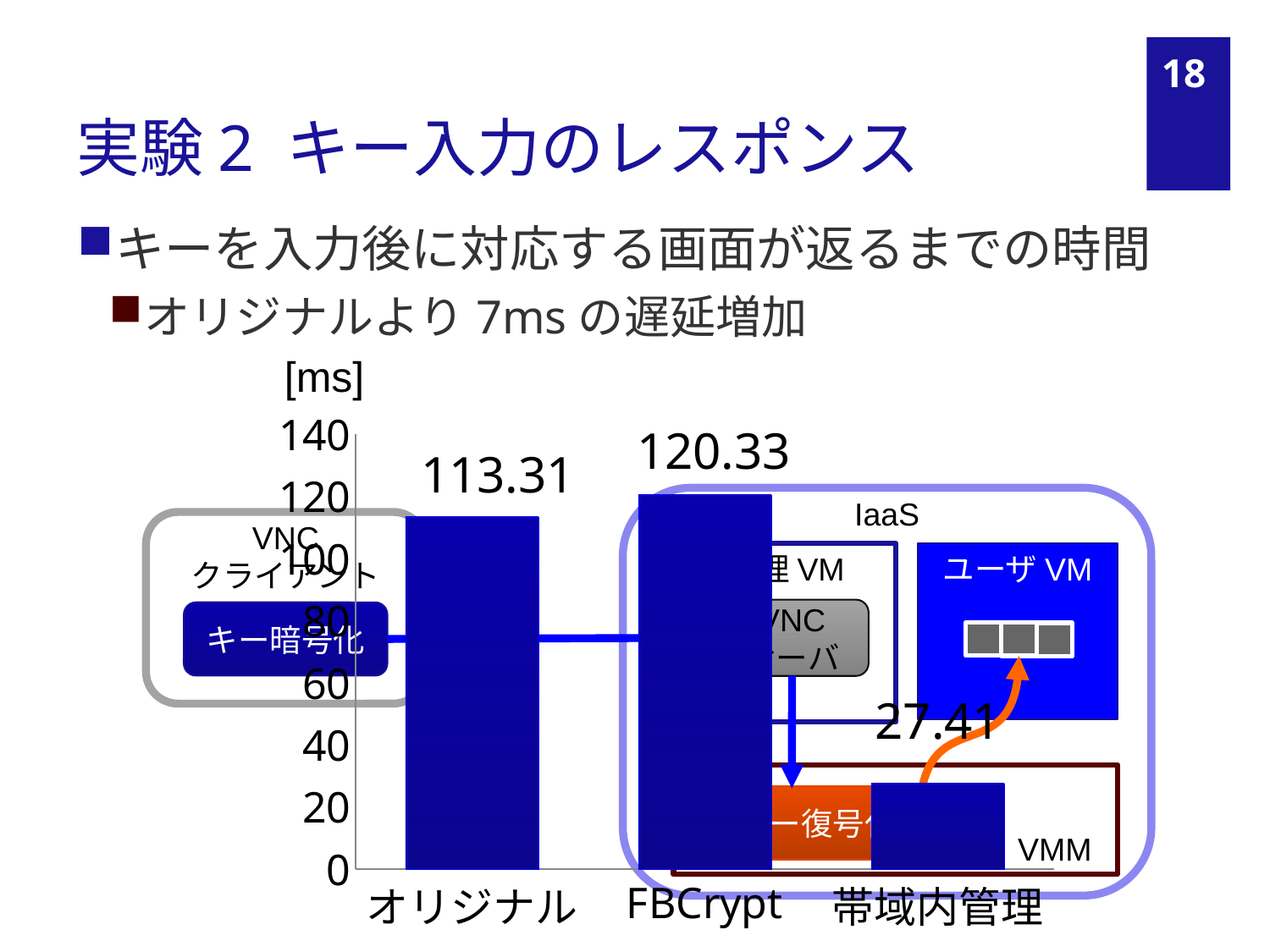
What is the difference between the values for FBCrypt and オリジナル? 7.02 Is the value for 帯域内管理 greater or less than 40? less What kind of chart is shown on the slide? bar chart What is the value for 帯域内管理? 27.41 What is the value for オリジナル? 113.31 What unit is shown on the y axis of the chart? [ms] What is the value for FBCrypt? 120.33 How many categories are shown on the x axis? 3 Which category has the highest value? FBCrypt Which is larger, the value for オリジナル or the value for 帯域内管理? オリジナル Which category has the lowest value? 帯域内管理 Is the value for FBCrypt greater or less than 120? greater